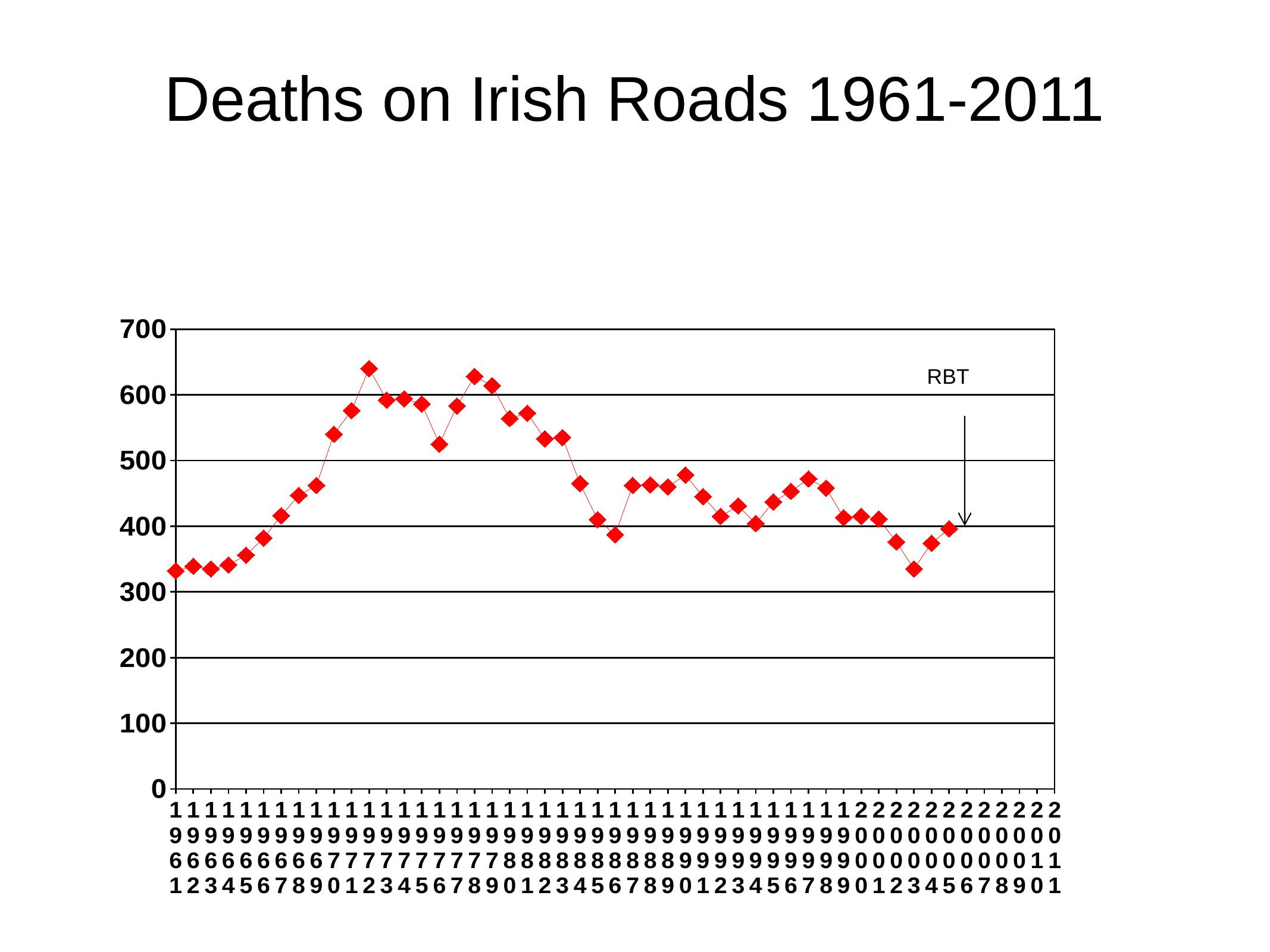
Do the values rise or fall from 1961 to 1972? Rise Which year has the larger value, 1972 or 1975? 1972 Is the value for 2004 greater or less than 400? less Which year has the highest number of deaths on the chart? 1972 Is the value for 1961 greater or less than 400? less What kind of chart is shown on the slide? Line chart How many years (data points) are plotted on the chart? 45 What is the title of the chart? Deaths on Irish Roads 1961-2011 Is the value for 1972 greater or less than 600? greater Which year does the arrow labelled RBT point to? 2006